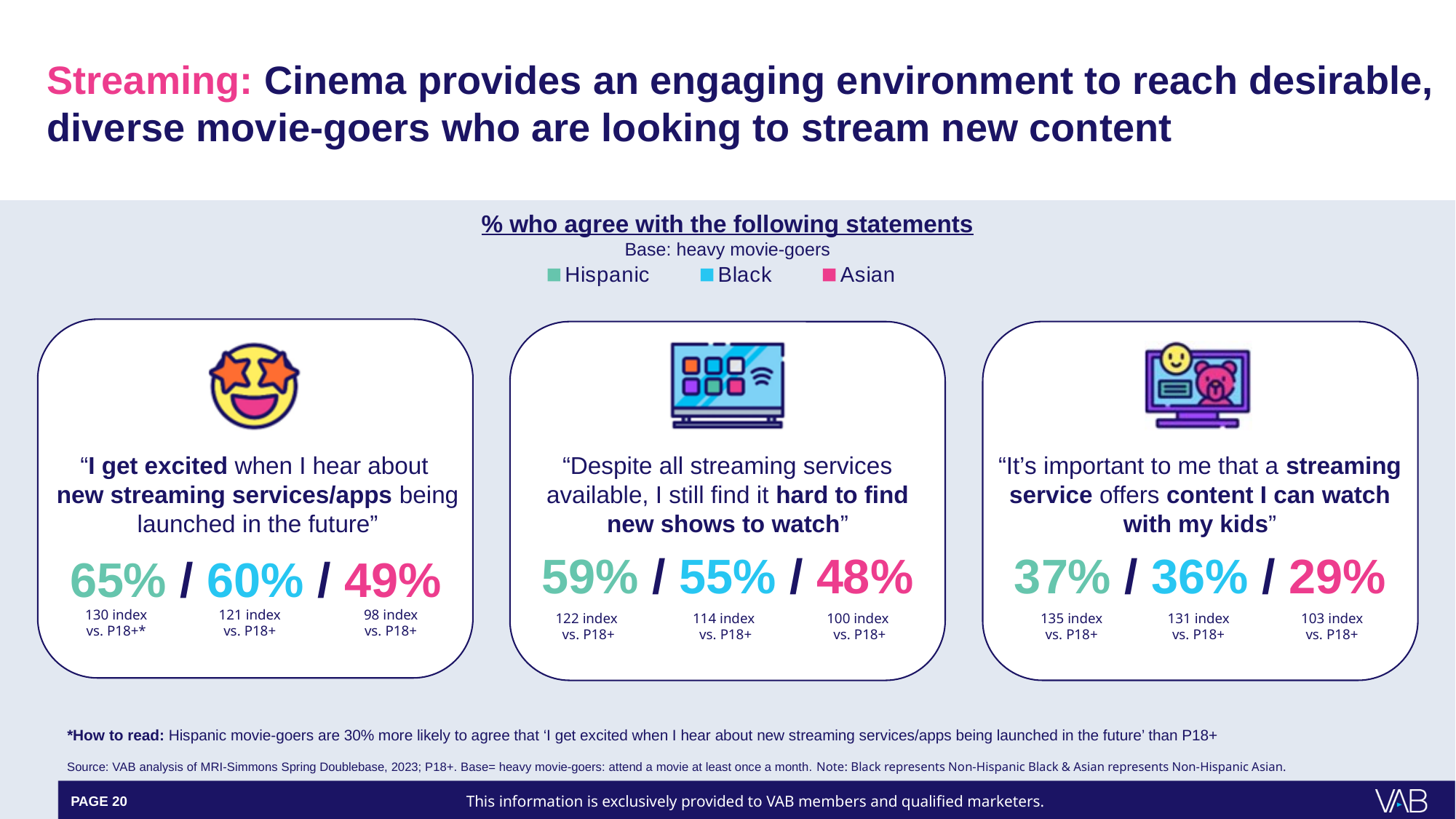
Which group has the highest agreement with "I get excited when I hear about new streaming services/apps being launched in the future"? Hispanic What percentage of Black heavy movie-goers agree that they still find it hard to find new shows to watch despite all streaming services available? 55% Which group has the lowest agreement with the statement about finding it hard to find new shows to watch? Asian What is the base population stated under the heading "% who agree with the following statements"? Heavy movie-goers Is the Hispanic or the Black agreement percentage higher for the statement about finding it hard to find new shows to watch? Hispanic How many groups does the legend list? 3 What is the difference between the Black and Asian agreement percentages for the statement about content to watch with kids? 7 percentage points How many statements are shown with agreement percentages? 3 What percentage of Asian heavy movie-goers agree that it's important that a streaming service offers content they can watch with their kids? 29% What is the difference in agreement between Hispanic and Asian movie-goers on the statement about getting excited about new streaming services/apps? 16 percentage points What percentage of Hispanic heavy movie-goers agree with "I get excited when I hear about new streaming services/apps being launched in the future"? 65% What is the index vs. P18+ for Hispanic movie-goers on the statement about content they can watch with their kids? 135 index